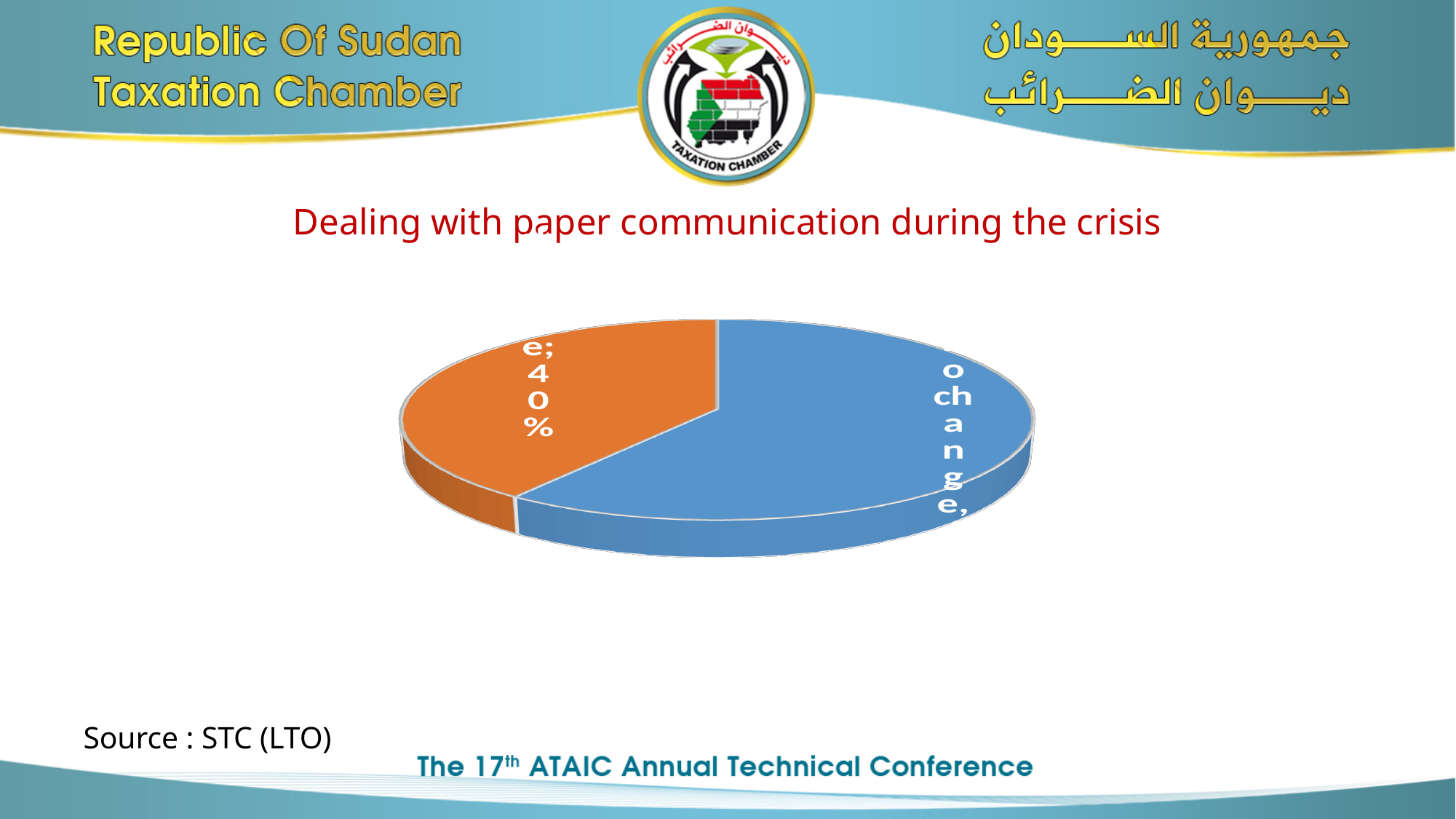
What is the title of the chart on the slide? Dealing with paper communication during the crisis What share of the pie does the orange slice represent? 40% What percentage is printed on the orange slice of the pie chart? 40% What colour is the slice labelled 40%? orange Which slice is larger, the blue one or the orange one? blue What kind of chart is shown on the slide? pie chart Which colour slice is the smallest in the pie chart? orange How many slices does the pie chart have? 2 Is the share of the orange slice greater or less than 50%? less Which colour slice is the largest in the pie chart? blue